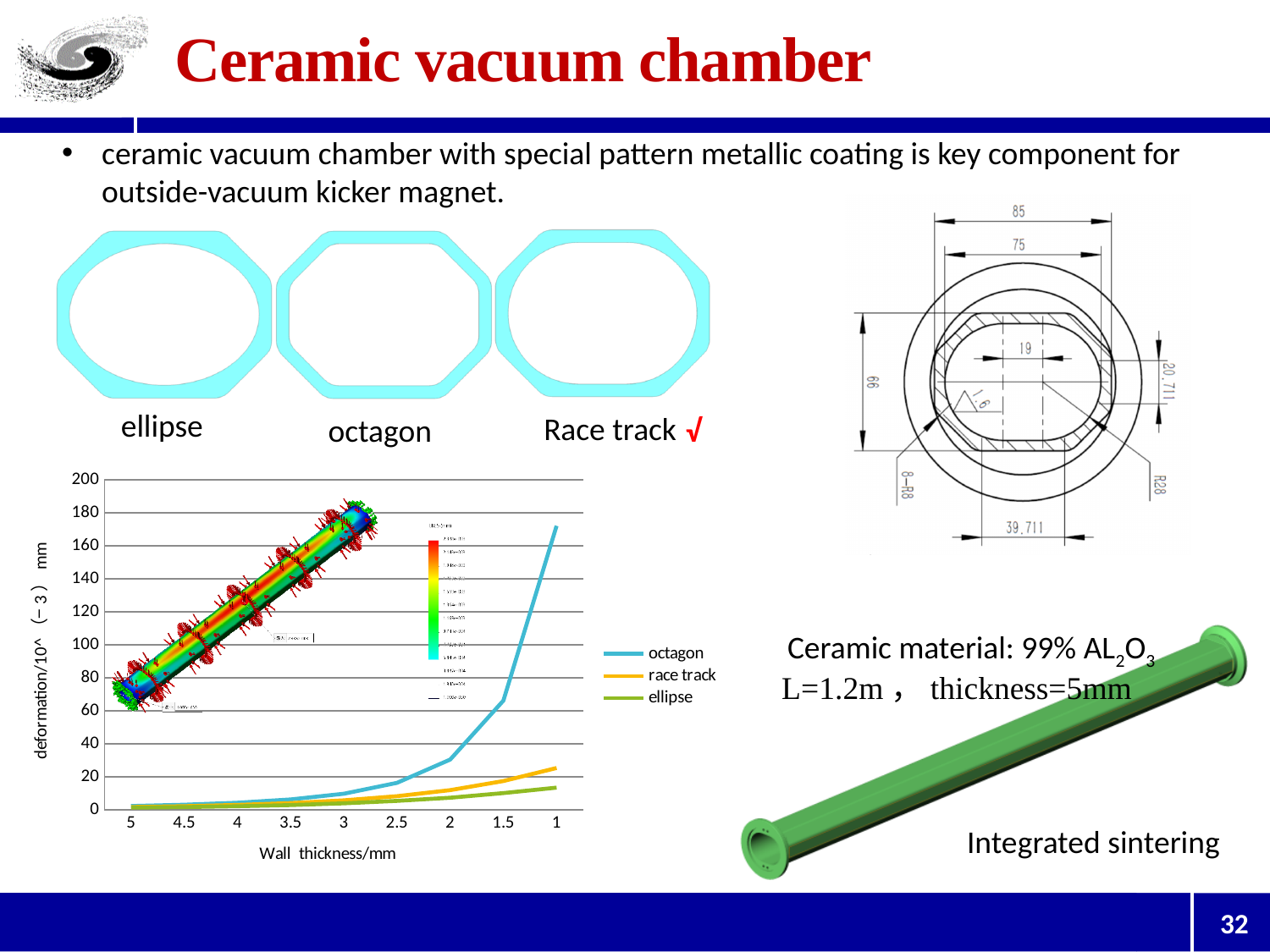
Which series has the highest deformation at a wall thickness of 1 mm? octagon Is the deformation of the octagon series at a wall thickness of 2 mm greater or less than 40? less Which series has the lowest deformation at a wall thickness of 1 mm? ellipse What is the label of the x axis of the chart? Wall thickness/mm Is the deformation of the ellipse series at a wall thickness of 1 mm greater or less than 20? less Is the deformation of the race track series at a wall thickness of 1 mm greater or less than 20? greater Does the deformation of the octagon series rise or fall as you move from left to right along the x axis (from 5 mm to 1 mm wall thickness)? rise At a wall thickness of 1 mm, which has the larger deformation, the race track series or the ellipse series? race track What kind of chart is shown on the slide? line chart How many wall thickness values are marked along the x axis of the chart? 9 How many series does the chart's legend list? 3